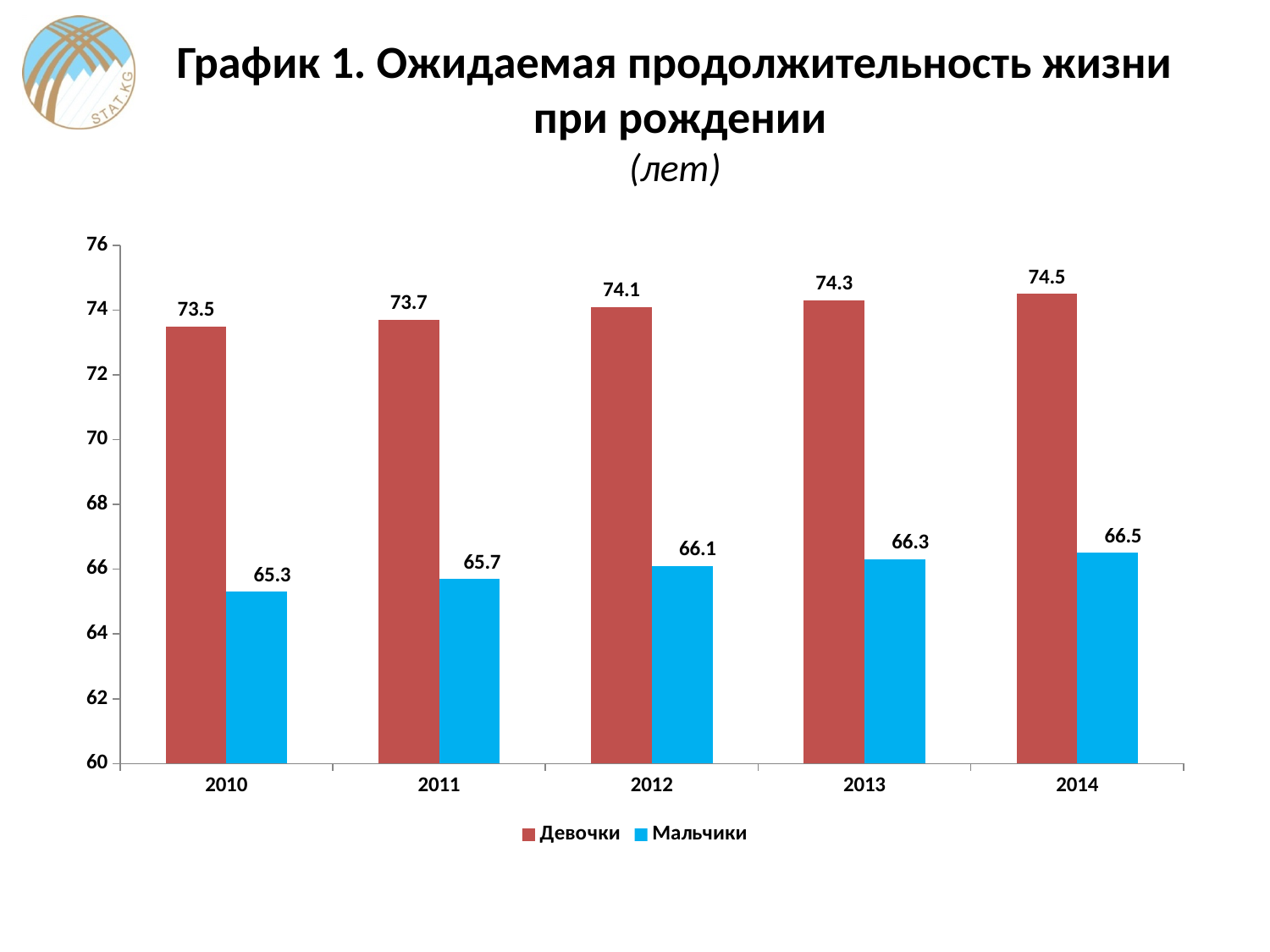
What kind of chart is shown on the slide? bar chart What is the difference between the Мальчики values in 2014 and 2010? 1.2 Is the value for Мальчики in 2012 greater or less than 68? less How many years are shown on the x axis? 5 How many series does the legend list? 2 What is the difference between the Девочки and Мальчики values in 2013? 8.0 What is the value for Девочки in 2012? 74.1 In which year is the value for Девочки highest? 2014 What is the value for Мальчики in 2014? 66.5 What is the value for Мальчики in 2010? 65.3 Which is larger in 2011: the value for Девочки or for Мальчики? Девочки In which year is the value for Мальчики lowest? 2010